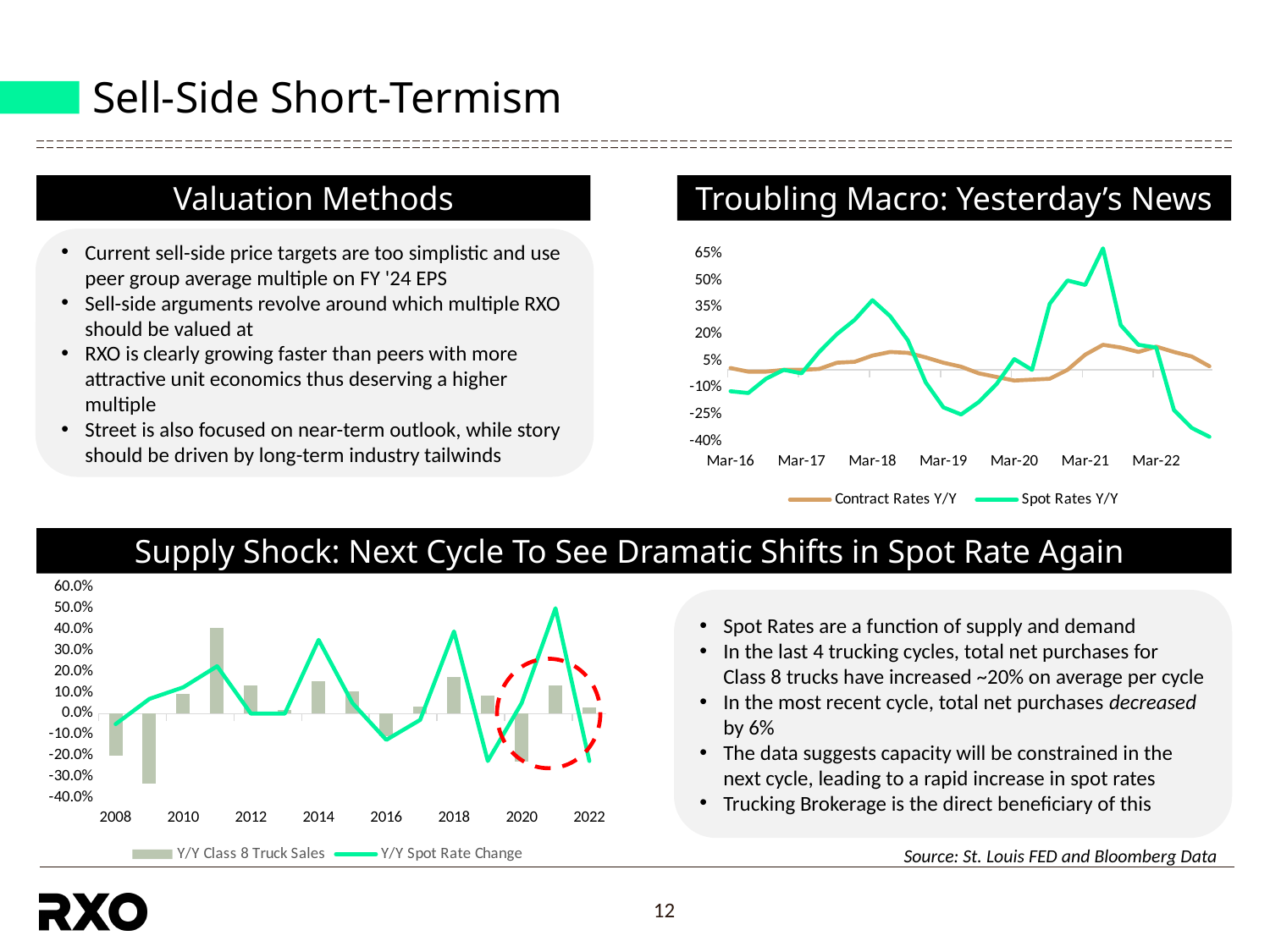
How many series does the legend of the 'Troubling Macro: Yesterday's News' chart list? 2 How many years are shown on the x axis of the 'Supply Shock' chart, from 2008 to 2022? 15 In the 'Supply Shock' chart, which year has the lowest Y/Y Class 8 Truck Sales bar? 2009 In the 'Supply Shock' chart, is the Y/Y Spot Rate Change for 2021 greater or less than 40.0%? greater In the 'Troubling Macro: Yesterday's News' chart, is the Spot Rates Y/Y value at Mar-19 greater or less than -10%? less In the 'Troubling Macro: Yesterday's News' chart, is the Spot Rates Y/Y value at Mar-18 greater or less than 20%? greater In the 'Supply Shock' chart, which year has the highest Y/Y Class 8 Truck Sales bar? 2011 In the 'Supply Shock' chart, which series is plotted as bars? Y/Y Class 8 Truck Sales In the 'Troubling Macro: Yesterday's News' chart, which series reaches the highest value? Spot Rates Y/Y What kind of chart is the 'Troubling Macro: Yesterday's News' chart? line chart In the 'Troubling Macro: Yesterday's News' chart, what colour is the Spot Rates Y/Y line? green